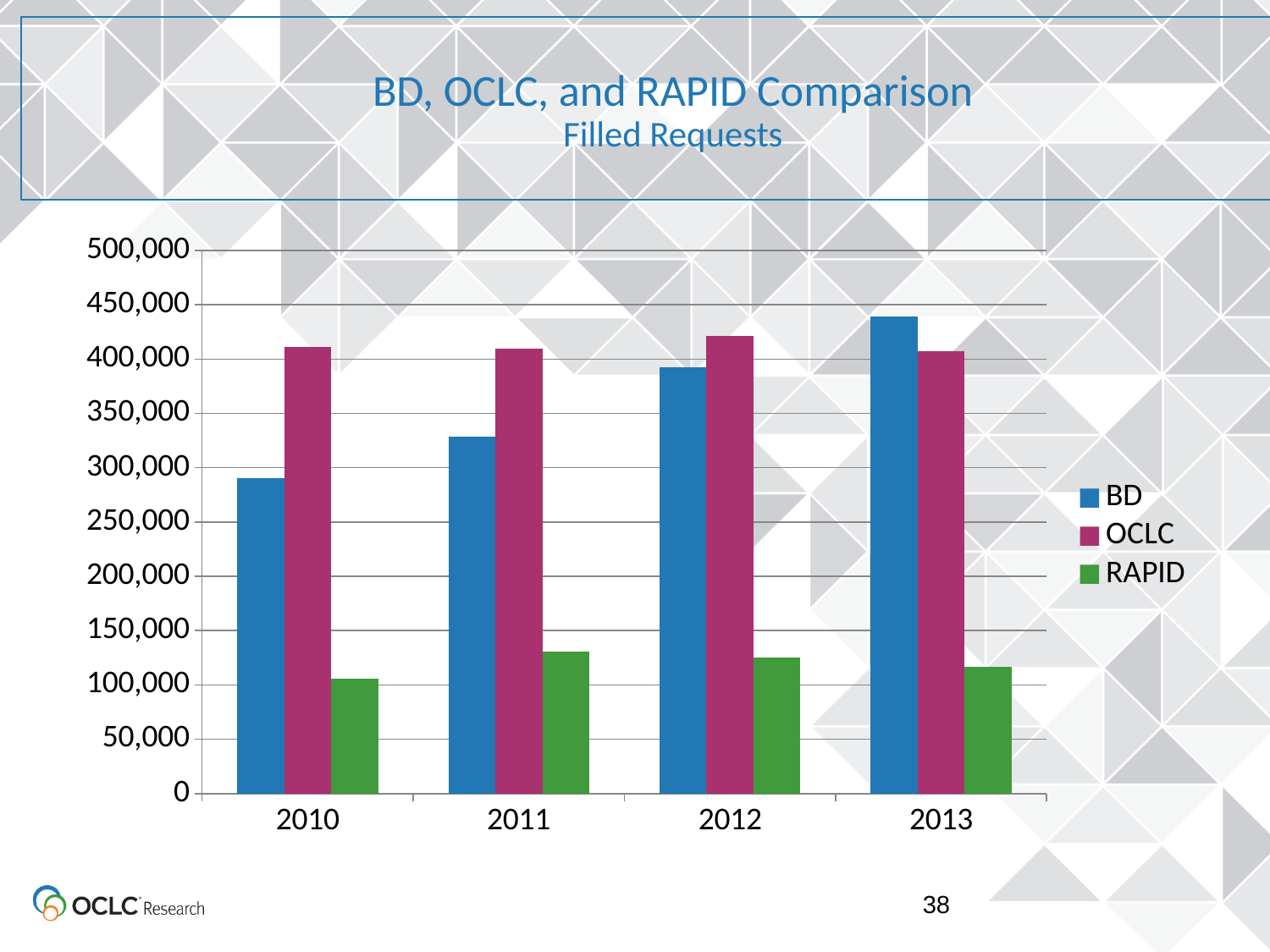
How many series does the legend list? 3 What kind of chart is shown on the slide? bar chart What is the title of the chart? BD, OCLC, and RAPID Comparison Filled Requests How many years are shown on the x axis? 4 Do the BD values rise or fall from 2010 to 2013? rise Is the BD value for 2010 greater or less than 300,000? less In 2010, which is larger, BD or OCLC? OCLC Is the RAPID value for 2011 greater or less than 150,000? less Is the OCLC value for 2012 greater or less than 400,000? greater In 2013, which is larger, BD or OCLC? BD In which year is the BD value highest? 2013 In which year is the RAPID value lowest? 2010